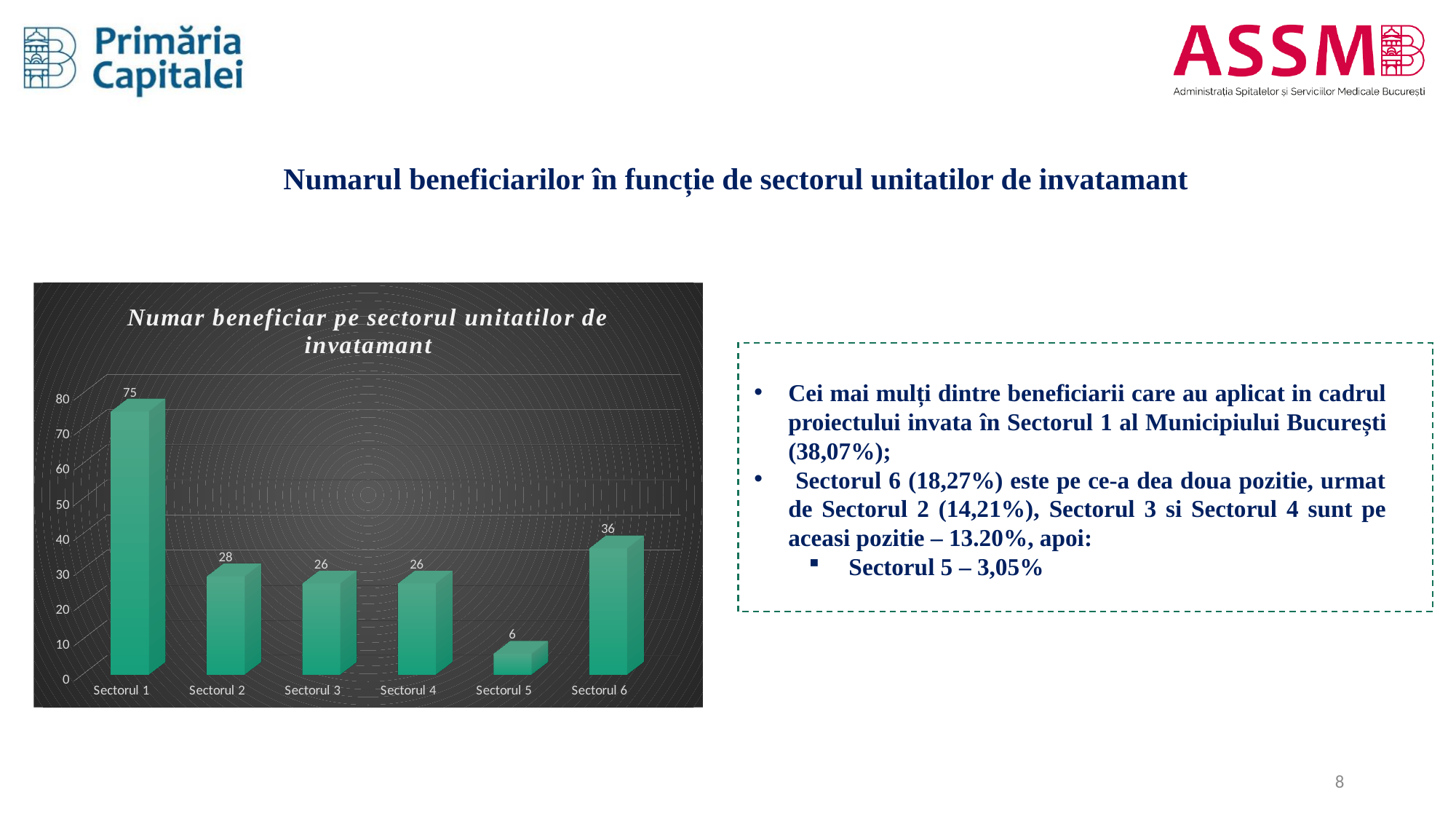
What is the title of the chart? Numar beneficiar pe sectorul unitatilor de invatamant Which sector has the highest number of beneficiaries? Sectorul 1 What is the value for Sectorul 5? 6 Which is larger, the value for Sectorul 6 or the value for Sectorul 2? Sectorul 6 What is the value for Sectorul 6? 36 What is the difference between the values for Sectorul 1 and Sectorul 6? 39 What is the difference between the values for Sectorul 2 and Sectorul 3? 2 Is the value for Sectorul 1 greater or less than 70? greater How many sectors are shown on the x axis? 6 What kind of chart is shown on the slide? Bar chart What is the value for Sectorul 1? 75 Which sector has the lowest number of beneficiaries? Sectorul 5